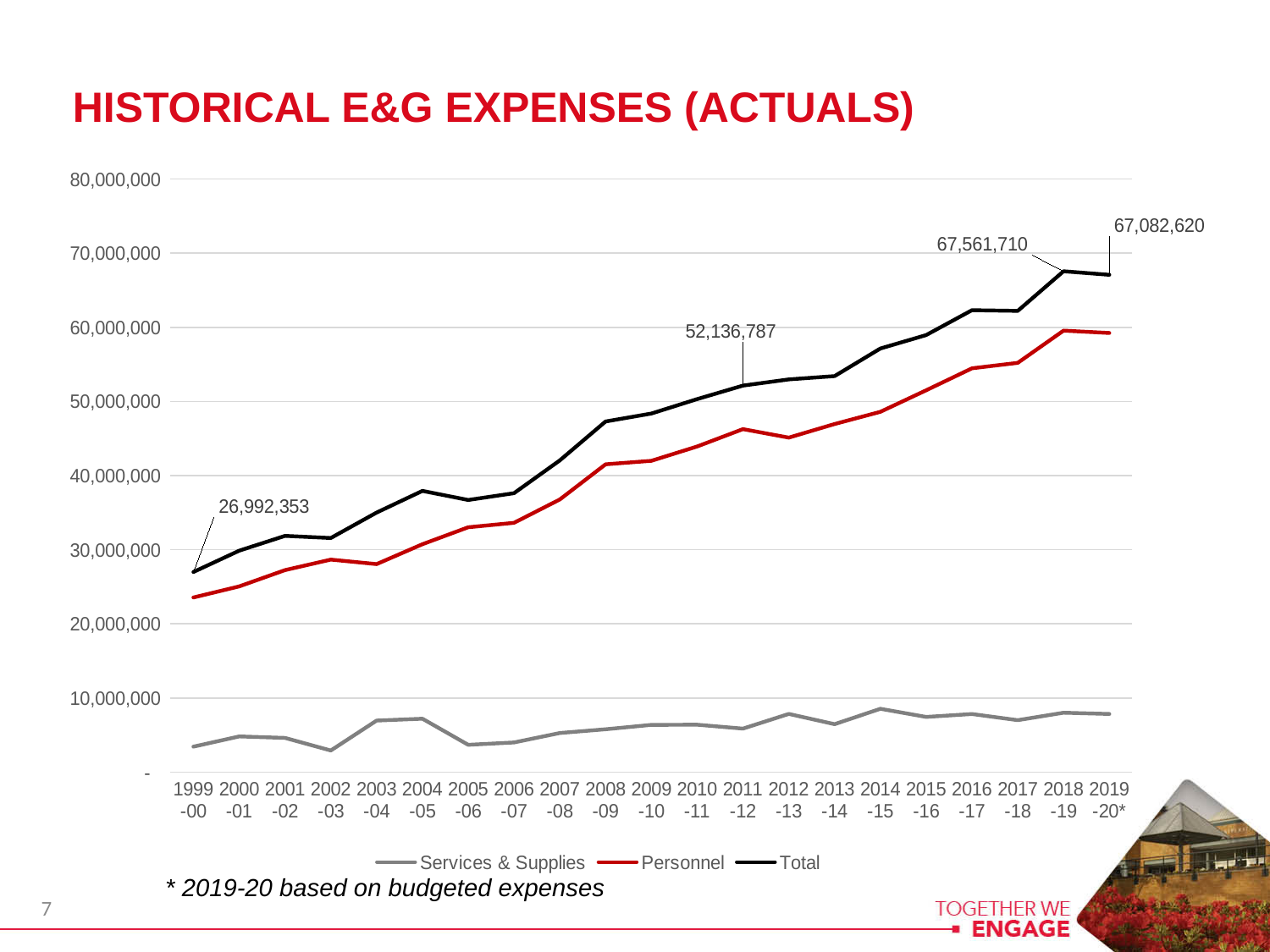
Which year has the higher Total value, 2018-19 or 2019-20*? 2018-19 How many fiscal years are shown on the x axis? 21 What is the Total value labeled for 2011-12? 52,136,787 How many series does the legend list? 3 By how much did the Total increase from 1999-00 to 2018-19? 40,569,357 What is the difference between the Total values for 2018-19 and 2019-20*? 479,090 Is the Personnel value for 2019-20* greater or less than 50,000,000? greater What is the Total value labeled for 2018-19? 67,561,710 What is the Total E&G expense value labeled for 1999-00? 26,992,353 What is the Total value labeled for 2019-20*? 67,082,620 Is the Services & Supplies value for 2014-15 greater or less than 10,000,000? less What kind of chart is shown on the slide? Line chart